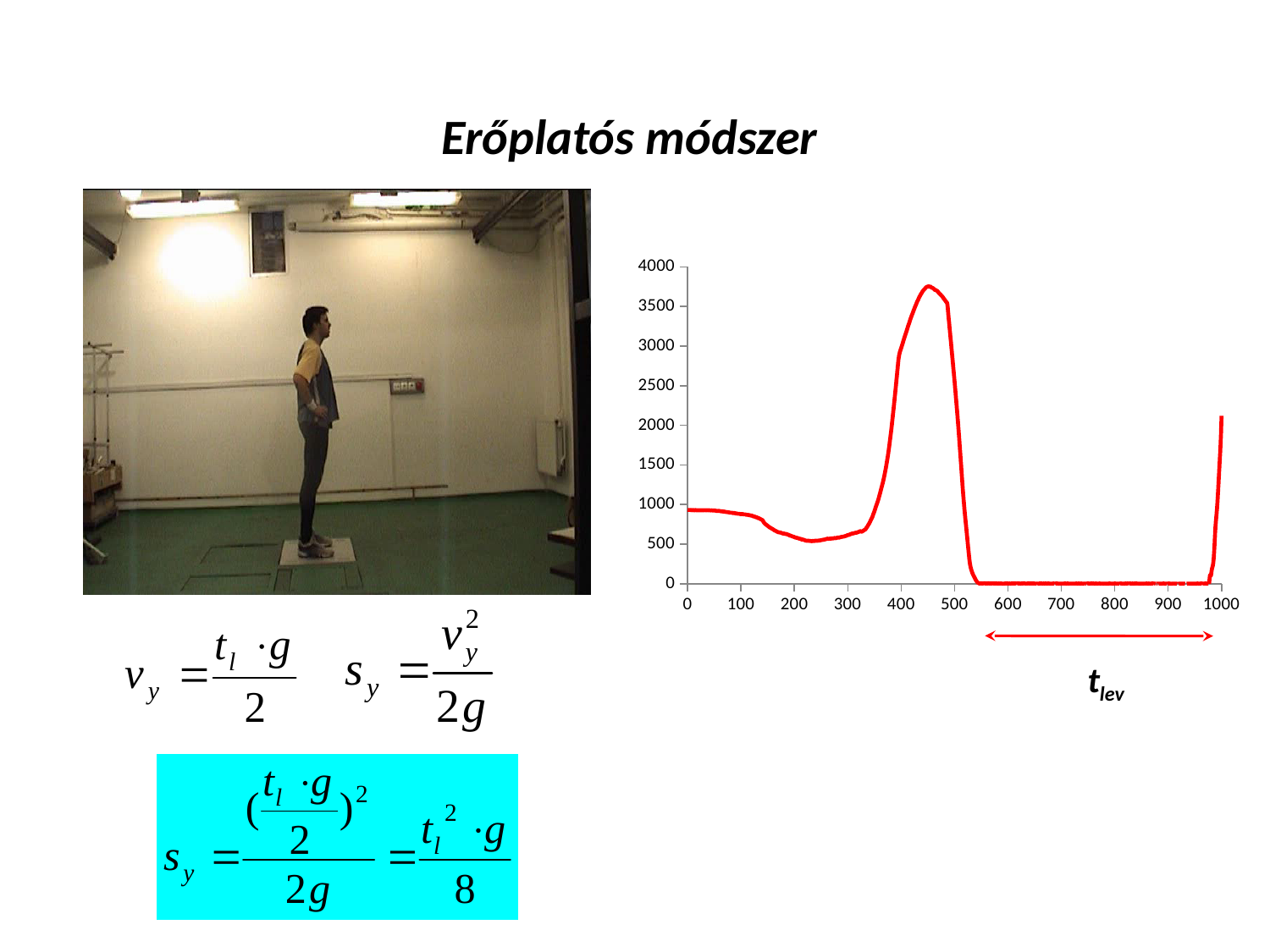
Is the value of the line at x = 1000 greater or less than 1500? greater Does the line rise or fall between x = 0 and x = 200? fall Is the peak value of the line in the chart greater or less than 3500? greater Does the line rise or fall between x = 300 and x = 450? rise Is the value of the line at x = 700 greater or less than 500? less What is the highest value shown on the chart's vertical axis? 4000 Does the line rise or fall between x = 450 and x = 550? fall What kind of chart is shown on the right side of the slide? line chart How many tick labels are shown on the chart's horizontal axis? 11 What colour is the line plotted in the chart? red